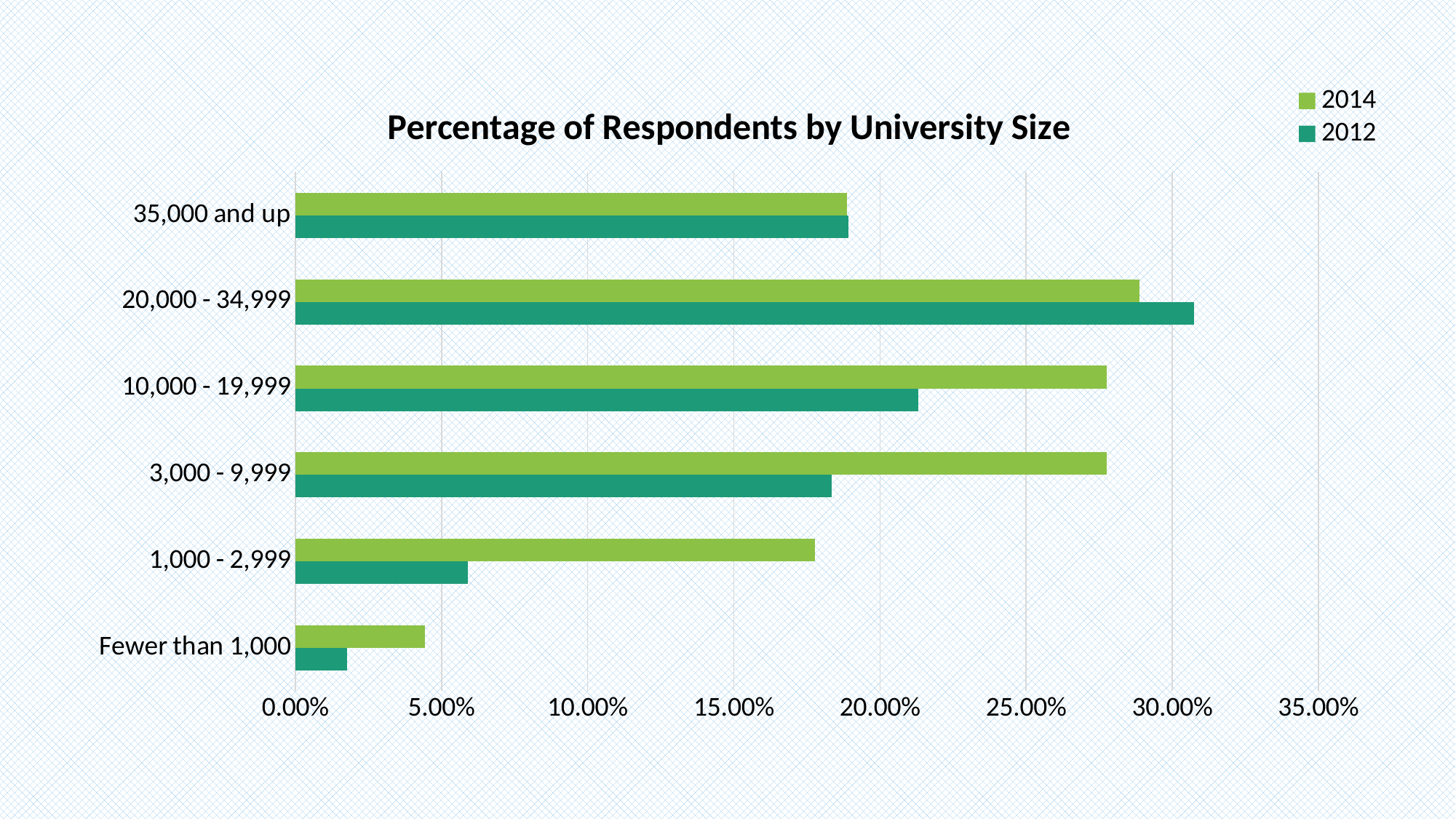
Is the 2012 value for 3,000 - 9,999 greater or less than 20.00%? less What is the title of the chart? Percentage of Respondents by University Size How many university size categories are shown on the chart? 6 For the 20,000 - 34,999 category, which year has the larger value, 2014 or 2012? 2012 Is the 2014 value for 3,000 - 9,999 greater or less than 25.00%? greater Is the 2014 value for 1,000 - 2,999 greater or less than 20.00%? less How many series does the legend list? 2 Which university size category has the lowest value for 2014? Fewer than 1,000 What kind of chart is shown on the slide? bar chart Which university size category has the highest value for 2012? 20,000 - 34,999 For the 10,000 - 19,999 category, which year has the larger value, 2014 or 2012? 2014